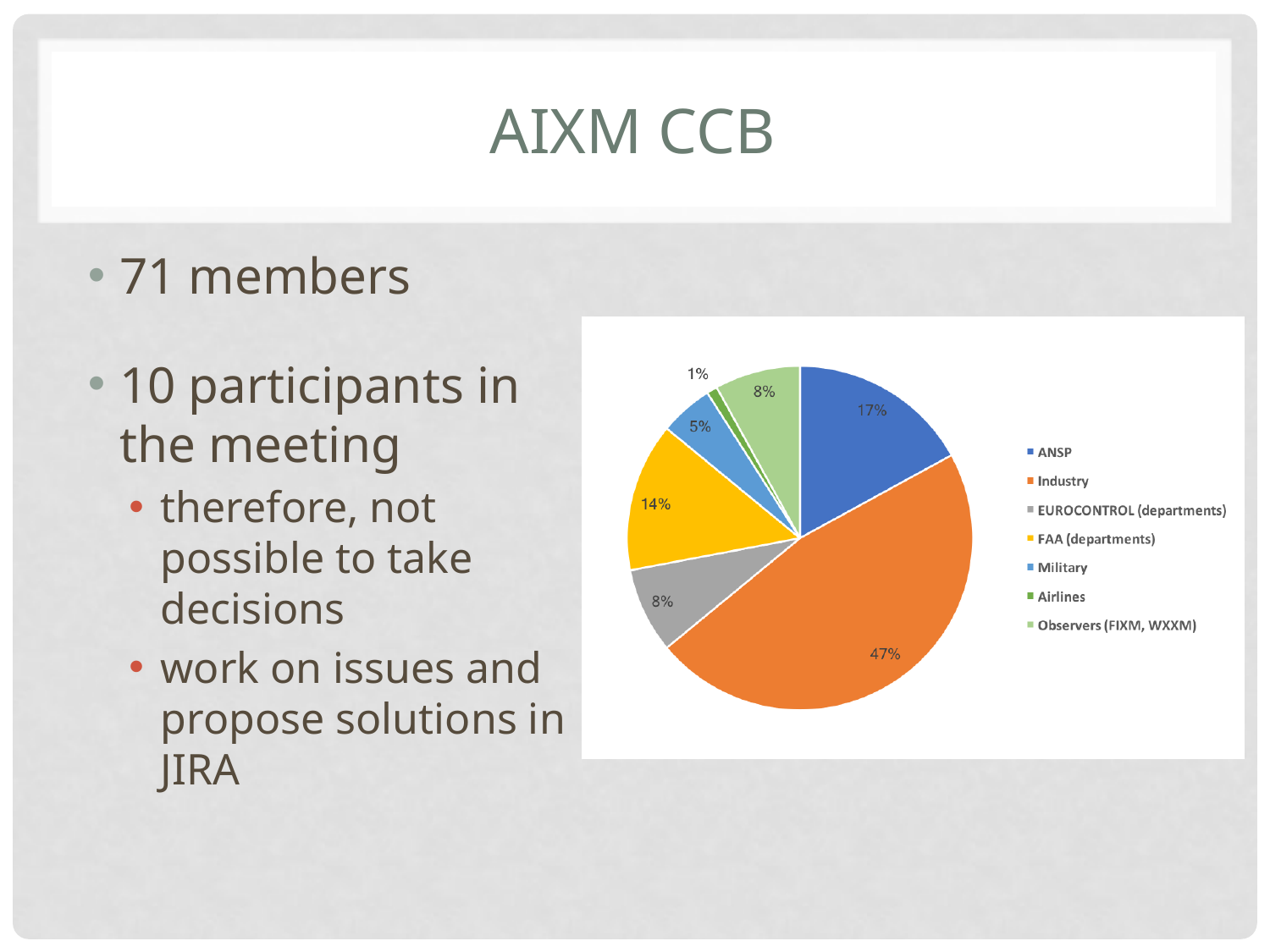
What share of the pie does FAA (departments) hold? 14% How many categories does the pie chart show? 7 What share of the pie does ANSP hold? 17% What share of the pie does Military hold? 5% Which category has the smallest slice of the pie? Airlines What colour is the Industry slice in the pie chart? Orange Which is larger, the FAA (departments) slice or the Military slice? FAA (departments) Which category has the largest slice of the pie? Industry What is the difference in percentage points between the Industry slice and the ANSP slice? 30 What kind of chart is shown on the slide? Pie chart